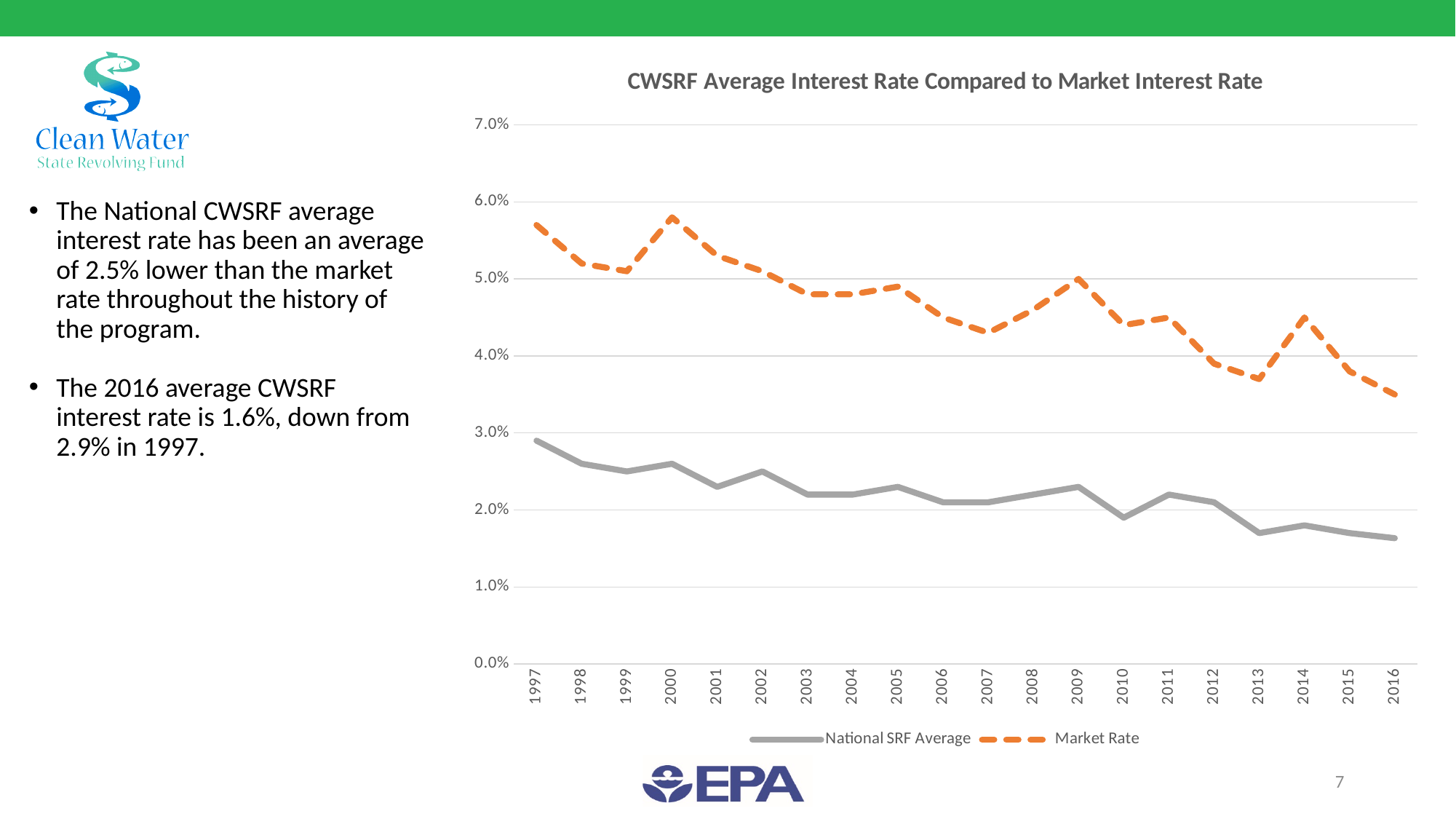
Which series is drawn with a dashed orange line? Market Rate How many series does the chart legend list? 2 What kind of chart is shown on the slide? line chart Is the Market Rate value for 2016 greater or less than 4.0%? less Is the Market Rate value for 2000 greater or less than 5.0%? greater By how much did the National SRF Average interest rate fall from 1997 to 2016? 1.3% Which series is higher in 2009, National SRF Average or Market Rate? Market Rate In which year was the National SRF Average at its highest? 1997 What was the National SRF Average interest rate in 2016? 1.6% What is the title of the chart? CWSRF Average Interest Rate Compared to Market Interest Rate How many years are plotted along the x axis of the chart? 20 What was the National SRF Average interest rate in 1997? 2.9%